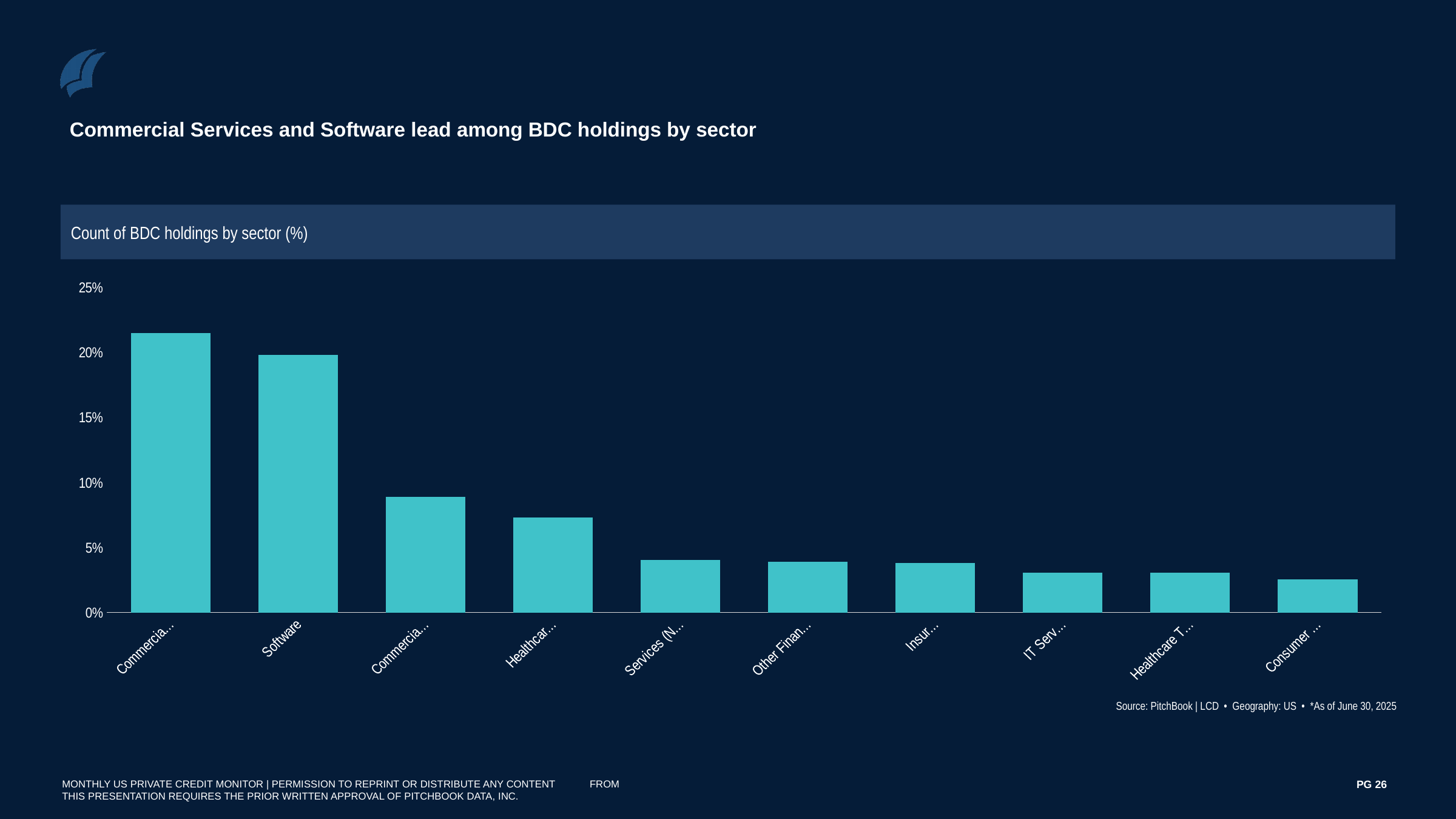
Is the value for Software greater or less than 15%? greater Is the value for the leftmost bar greater or less than 20%? greater Do the bar values rise or fall moving from left to right along the x axis? fall Which bar is the shortest in the chart? the rightmost bar (Consumer ...) What is the highest tick label shown on the y axis? 25% How many bars (sectors) are plotted in the chart? 10 What kind of chart is shown on the slide? bar chart Which bar is the tallest in the chart? the leftmost bar Is the value for the rightmost bar (Consumer ...) greater or less than 5%? less What is the title of the chart? Count of BDC holdings by sector (%) Which is larger, the value for Software or the value for the leftmost bar? the leftmost bar